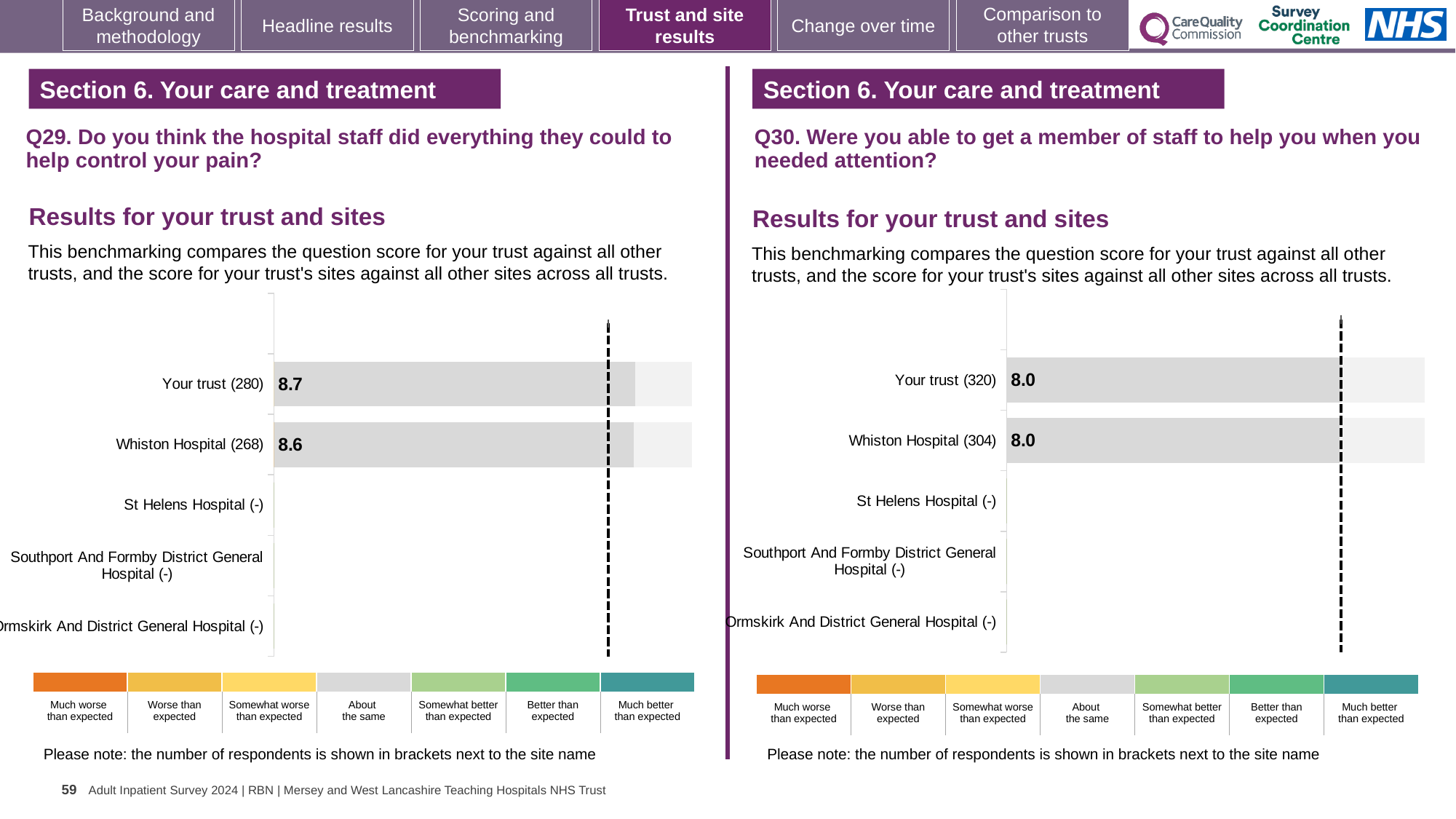
On the Q30 chart (right), how many site/trust categories are listed on the vertical axis? 5 On the Q29 chart (left), what is the difference between the Your trust score and the Whiston Hospital score? 0.1 On the Q30 chart (right), how many respondents are shown in brackets for Whiston Hospital? 304 On the Q29 chart (left), how many sites show no score (marked with a dash)? 3 On the Q29 chart (left), what is the score for Whiston Hospital? 8.6 On the Q29 chart (left), what is the score for Your trust? 8.7 On the Q29 chart (left), how many respondents are shown in brackets for Your trust? 280 On the Q30 chart (right), what is the score for Whiston Hospital? 8.0 What kind of chart is used on the Q29 chart (left)? Bar chart On the Q29 chart (left), which has the higher score, Your trust or Whiston Hospital? Your trust On the Q30 chart (right), what is the score for Your trust? 8.0 On the Q30 chart (right), how many categories does the colour legend below the chart list? 7